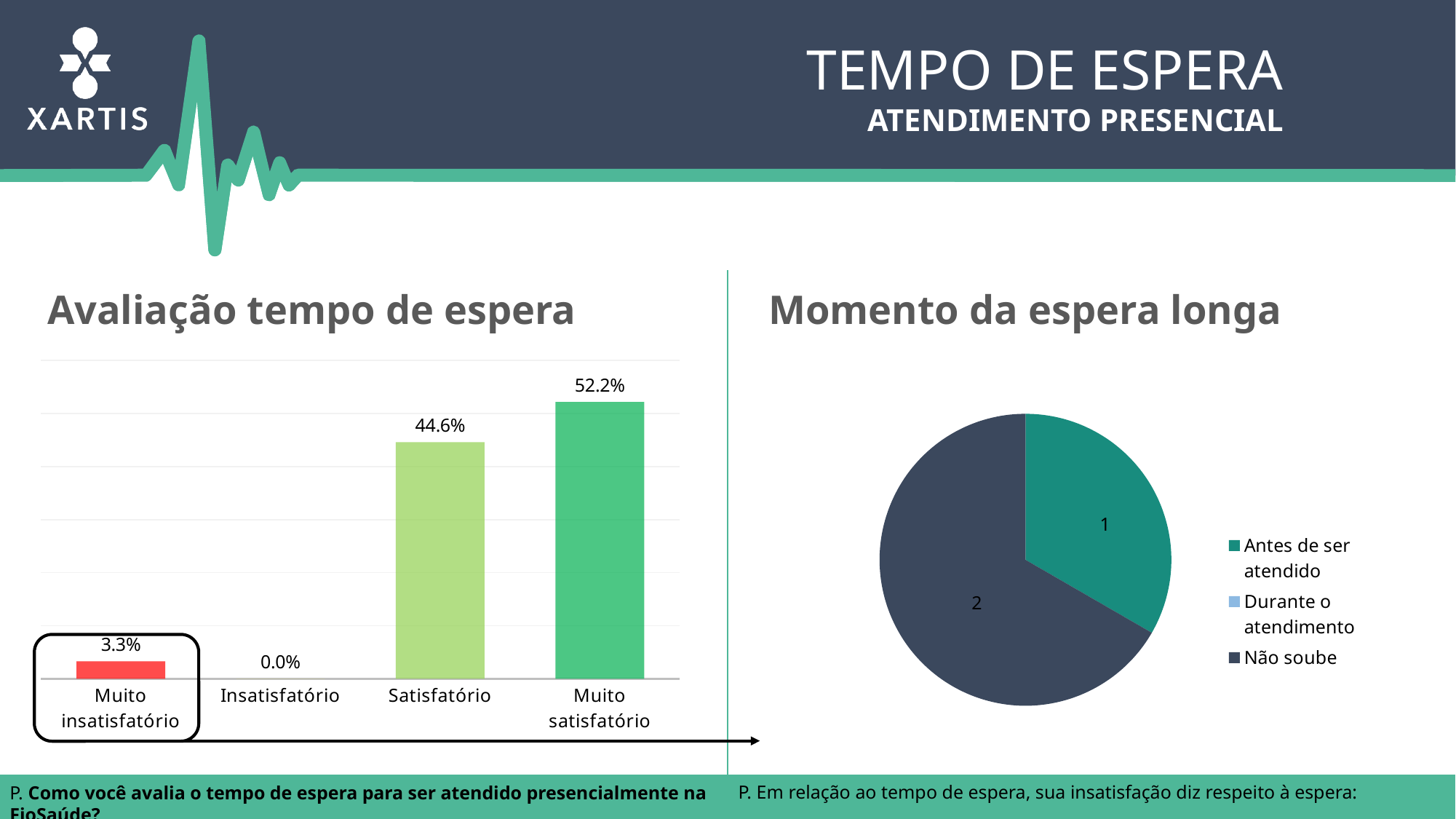
In the 'Avaliação tempo de espera' chart, what is the value for Muito satisfatório? 52.2% In the 'Avaliação tempo de espera' chart, what is the value for Satisfatório? 44.6% In the 'Avaliação tempo de espera' chart, which category has the lowest value? Insatisfatório How many entries does the legend of the 'Momento da espera longa' chart list? 3 In the 'Momento da espera longa' chart, what is the value labelled for Não soube? 2 In the 'Avaliação tempo de espera' chart, which is larger: Satisfatório or Muito insatisfatório? Satisfatório What kind of chart is 'Momento da espera longa'? Pie chart In the 'Avaliação tempo de espera' chart, what is the value for Muito insatisfatório? 3.3% How many categories are shown in the 'Avaliação tempo de espera' chart? 4 In the 'Avaliação tempo de espera' chart, which category has the highest value? Muito satisfatório What kind of chart is 'Avaliação tempo de espera'? Bar chart In the 'Avaliação tempo de espera' chart, what is the difference between Muito satisfatório and Satisfatório? 7.6%